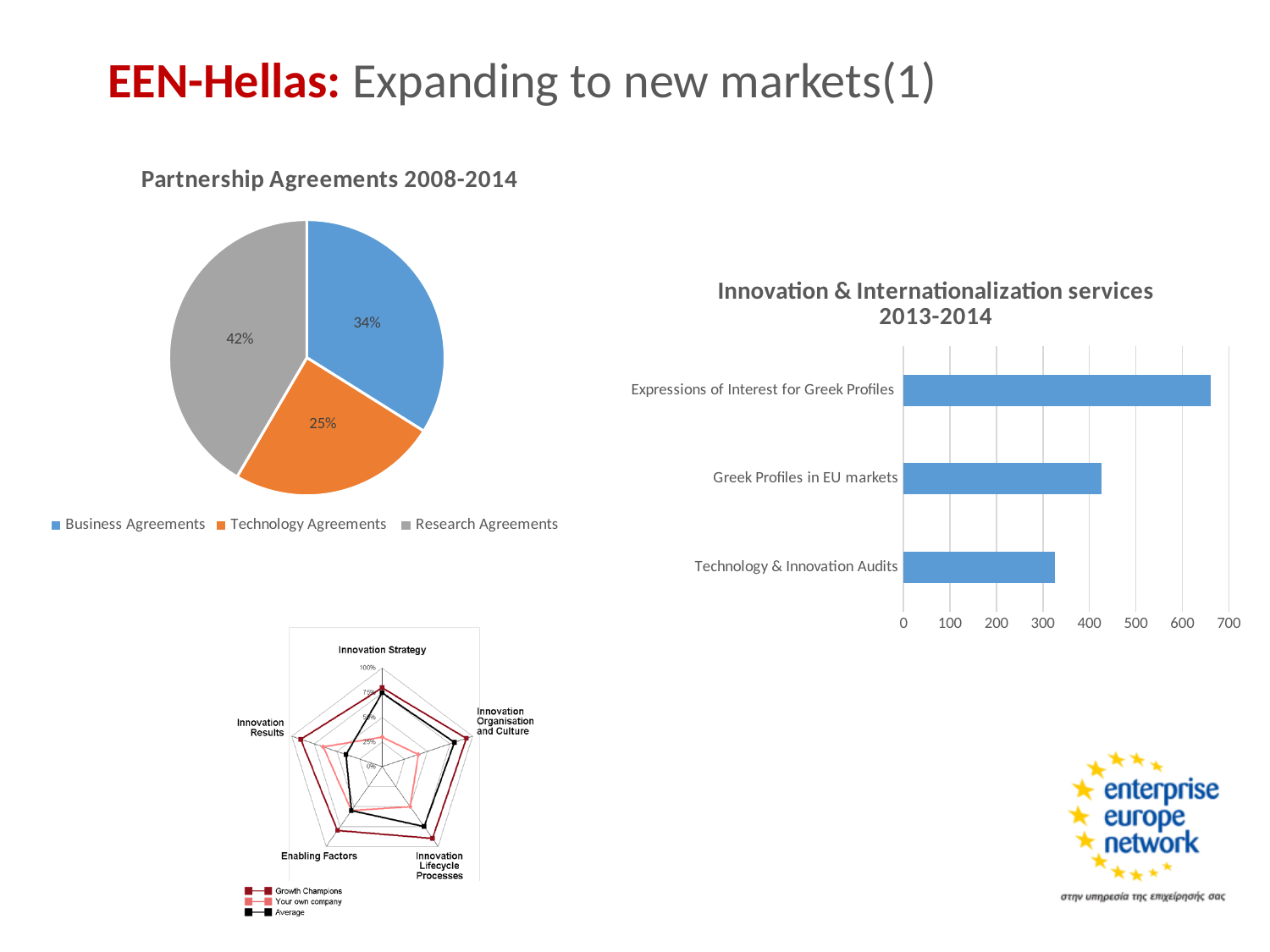
In the Innovation & Internationalization services 2013-2014 chart, which category has the highest value? Expressions of Interest for Greek Profiles In the radar chart at the bottom left of the slide, how many series does the legend list? 3 In the Partnership Agreements 2008-2014 pie chart, what is the difference in percentage points between Research Agreements and Business Agreements? 8 In the Partnership Agreements 2008-2014 pie chart, what share is Business Agreements? 34% In the Innovation & Internationalization services 2013-2014 chart, is the value for Expressions of Interest for Greek Profiles greater or less than 600? greater In the Partnership Agreements 2008-2014 pie chart, how many categories are shown? 3 In the Partnership Agreements 2008-2014 pie chart, what share is Technology Agreements? 25% What kind of chart is the Innovation & Internationalization services 2013-2014 chart? Bar chart In the Partnership Agreements 2008-2014 pie chart, which category has the largest share? Research Agreements In the Innovation & Internationalization services 2013-2014 chart, is the value for Technology & Innovation Audits greater or less than 400? less What kind of chart is the Partnership Agreements 2008-2014 chart? Pie chart In the Partnership Agreements 2008-2014 pie chart, which category has the smallest share? Technology Agreements